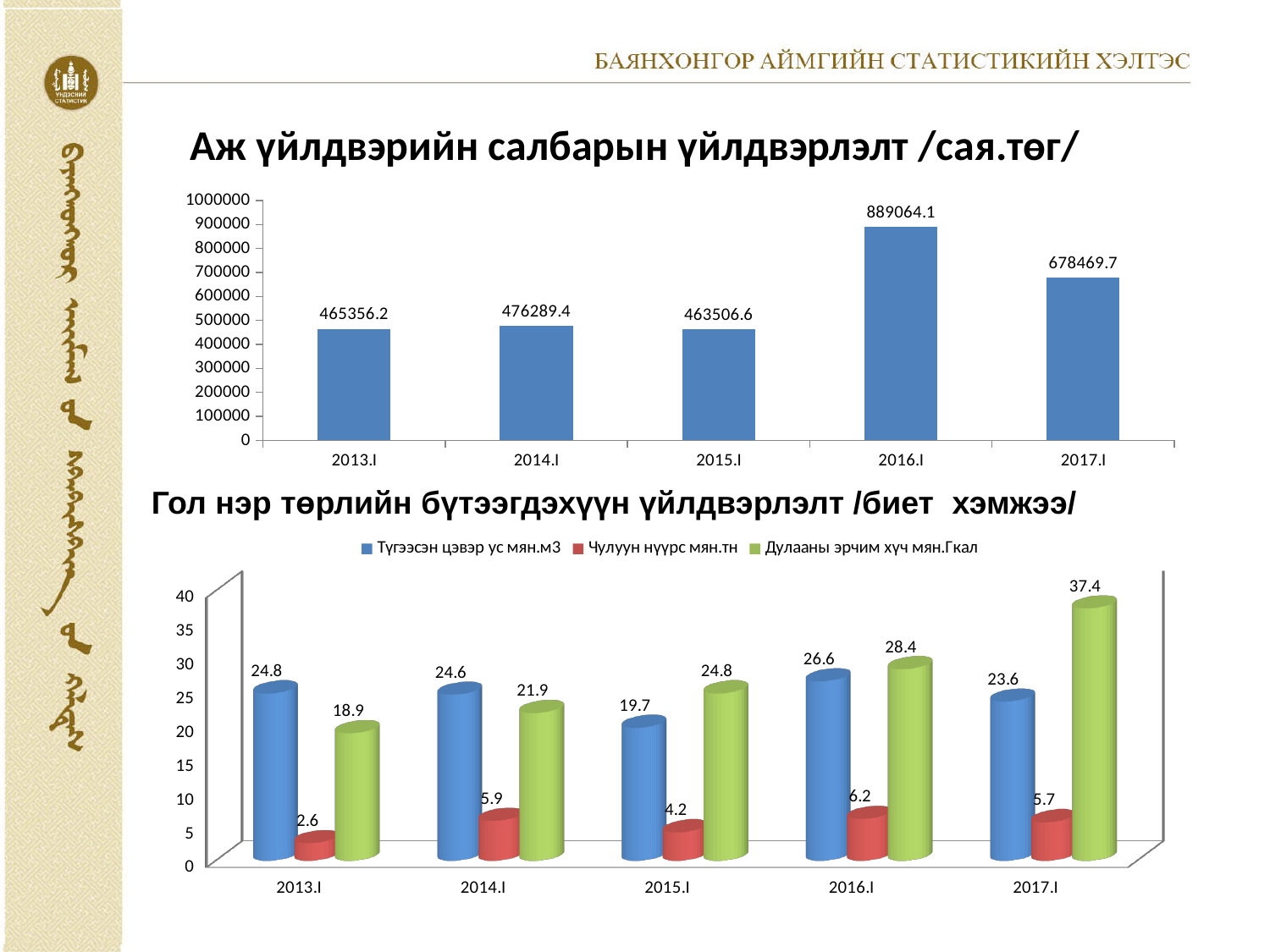
In the top chart (Аж үйлдвэрийн салбарын үйлдвэрлэлт), which period has the lowest value? 2015.I In the bottom chart (Гол нэр төрлийн бүтээгдэхүүн үйлдвэрлэлт), do the values for Дулааны эрчим хүч мян.Гкал rise or fall from 2013.I to 2017.I? rise In the top chart (Аж үйлдвэрийн салбарын үйлдвэрлэлт), is the value for 2017.I greater or less than 600000? greater In the top chart (Аж үйлдвэрийн салбарын үйлдвэрлэлт), what is the difference between the 2016.I and 2017.I values? 210594.4 In the bottom chart (Гол нэр төрлийн бүтээгдэхүүн үйлдвэрлэлт), what is the value of Дулааны эрчим хүч мян.Гкал for 2017.I? 37.4 In the bottom chart (Гол нэр төрлийн бүтээгдэхүүн үйлдвэрлэлт), how many series does the legend list? 3 In the top chart (Аж үйлдвэрийн салбарын үйлдвэрлэлт), how many periods are shown on the x axis? 5 What kind of chart is the top chart (Аж үйлдвэрийн салбарын үйлдвэрлэлт)? bar chart In the bottom chart (Гол нэр төрлийн бүтээгдэхүүн үйлдвэрлэлт), what is the value of Чулуун нүүрс мян.тн for 2013.I? 2.6 In the bottom chart (Гол нэр төрлийн бүтээгдэхүүн үйлдвэрлэлт), which is larger for 2015.I: Түгээсэн цэвэр ус мян.м3 or Дулааны эрчим хүч мян.Гкал? Дулааны эрчим хүч мян.Гкал In the top chart (Аж үйлдвэрийн салбарын үйлдвэрлэлт), what is the value for 2016.I? 889064.1 In the bottom chart (Гол нэр төрлийн бүтээгдэхүүн үйлдвэрлэлт), which period has the highest value for Чулуун нүүрс мян.тн? 2016.I